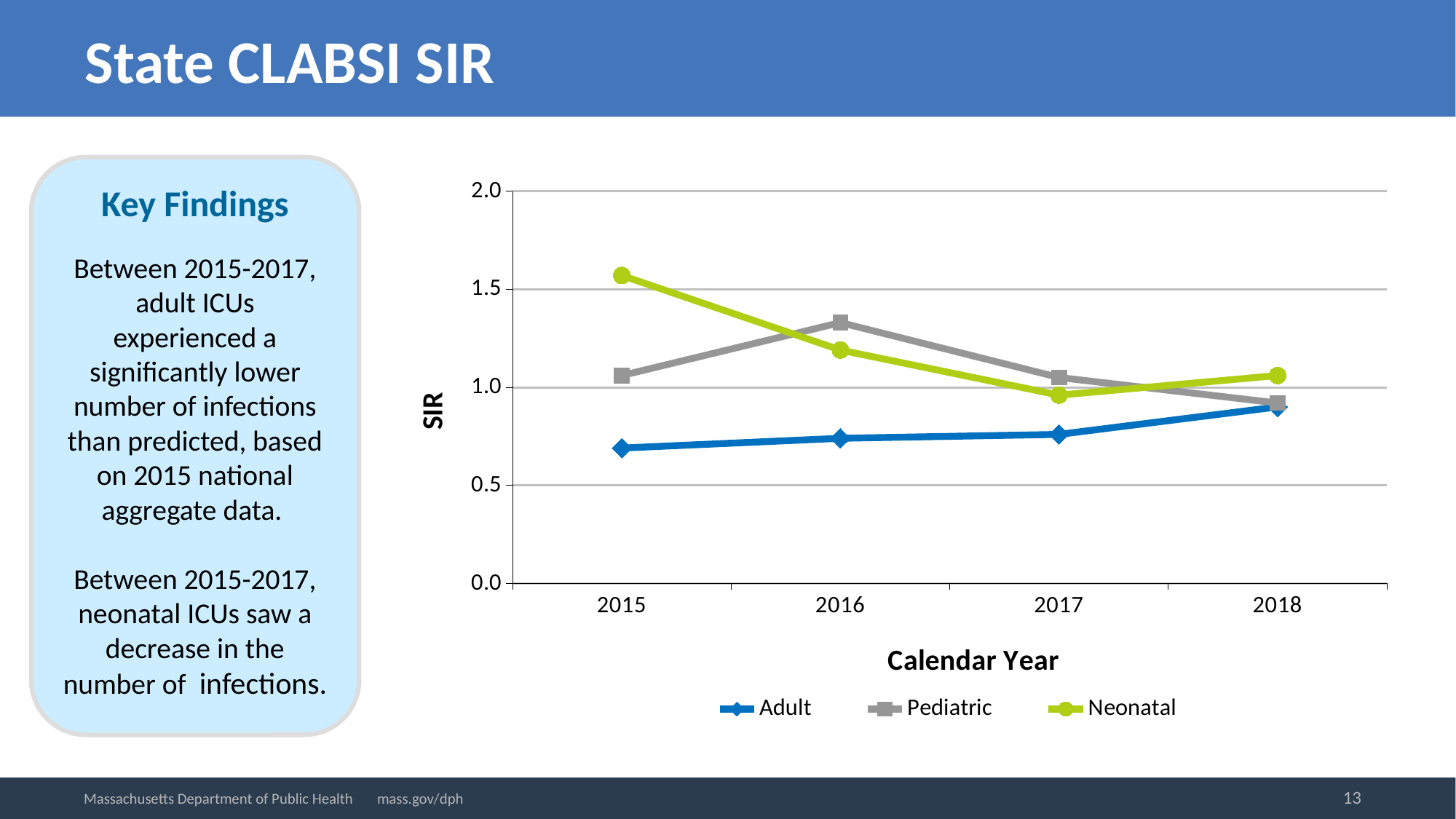
What is the title of the x axis? Calendar Year How many series does the legend list? 3 How many calendar years are plotted on the x axis? 4 Is the Neonatal SIR in 2015 greater or less than 1.5? greater Is the Adult SIR in 2018 greater or less than 1.0? less Does the Adult SIR rise or fall from 2015 to 2018? rise What kind of chart is shown on the slide? line chart Which series has the highest SIR in 2016? Pediatric Which series has the highest SIR in 2015? Neonatal Does the Neonatal SIR rise or fall from 2015 to 2017? fall Is the Pediatric SIR in 2016 greater or less than 1.0? greater Which series has the lowest SIR in 2015? Adult